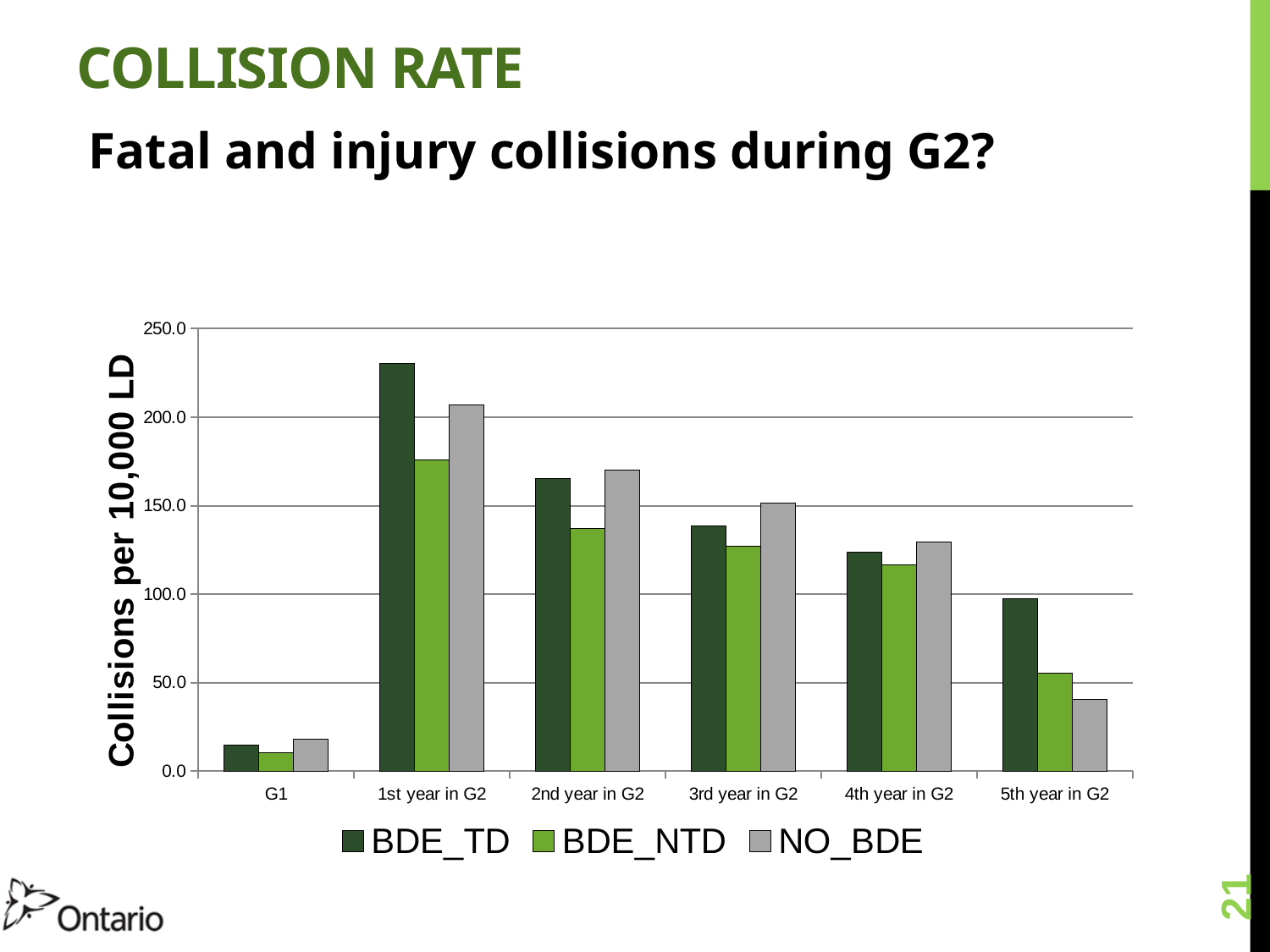
What kind of chart is shown on the slide? bar chart What is the title of the y axis? Collisions per 10,000 LD For 5th year in G2, which is larger: BDE_NTD or NO_BDE? BDE_NTD How many categories are shown on the x axis? 6 Which category has the lowest BDE_NTD value? G1 For 1st year in G2, which is larger: BDE_TD or NO_BDE? BDE_TD Is the NO_BDE value for 5th year in G2 greater or less than 50.0? less Which category has the highest BDE_TD value? 1st year in G2 Is the NO_BDE value for 4th year in G2 greater or less than 150.0? less How many series does the legend list? 3 From 1st year in G2 to 5th year in G2, do the BDE_TD values rise or fall? fall Is the BDE_TD value for 1st year in G2 greater or less than 200.0? greater